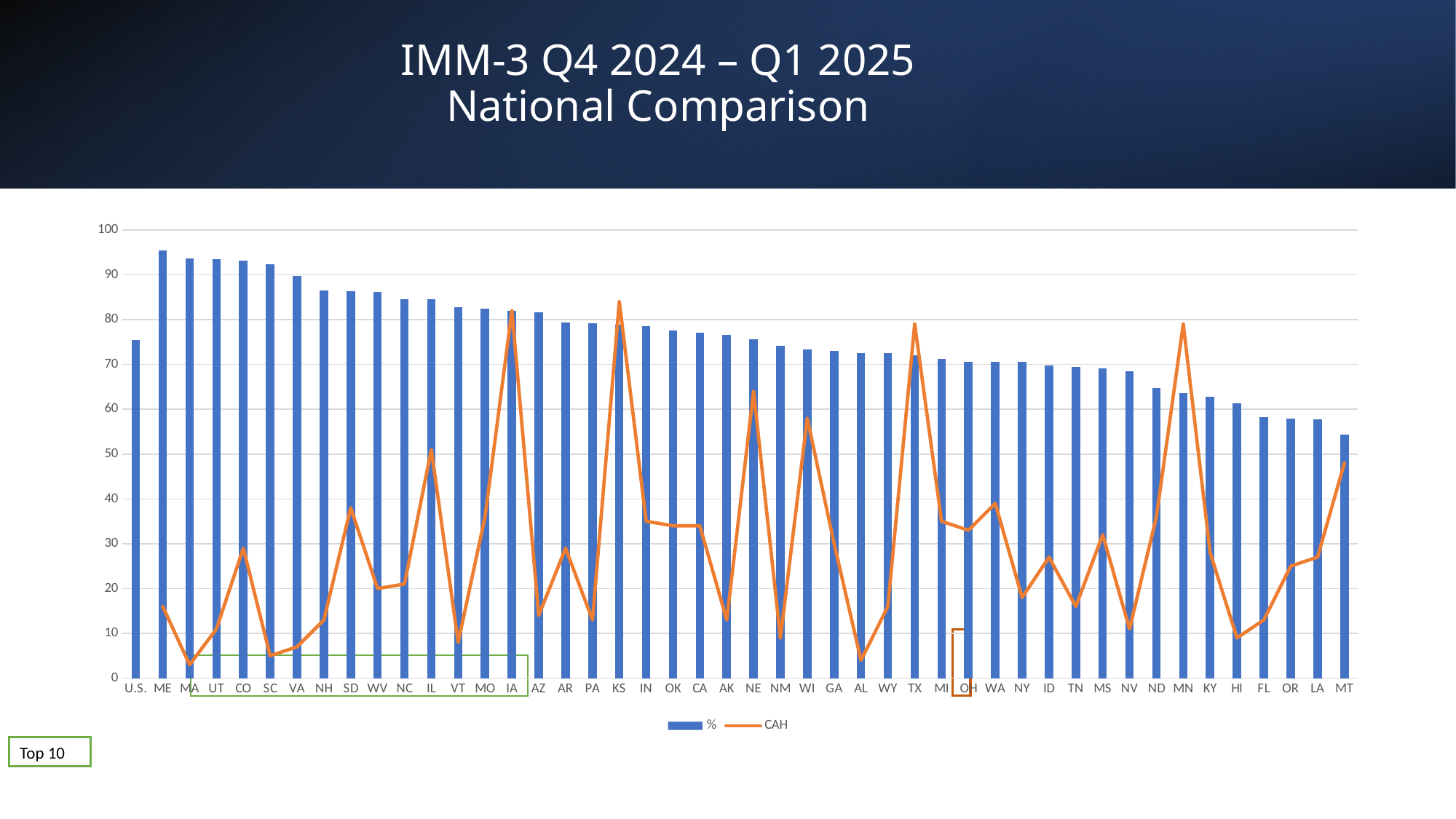
Is the CAH value for AL greater or less than 10? less Which has the larger CAH value, NE or NM? NE What are the two series named in the legend? % and CAH Which category has the highest point on the CAH line? KS Do the % bars generally rise or fall moving from ME on the left to MT on the right? fall What kind of chart is shown on the slide? A bar chart combined with a line chart How many categories are shown along the x axis? 46 How many series does the legend list? 2 Which category has the highest bar for the % series? ME Which category has the lowest bar for the % series? MT Is the % bar for MT greater or less than 60? less Is the % bar for U.S. greater or less than 70? greater